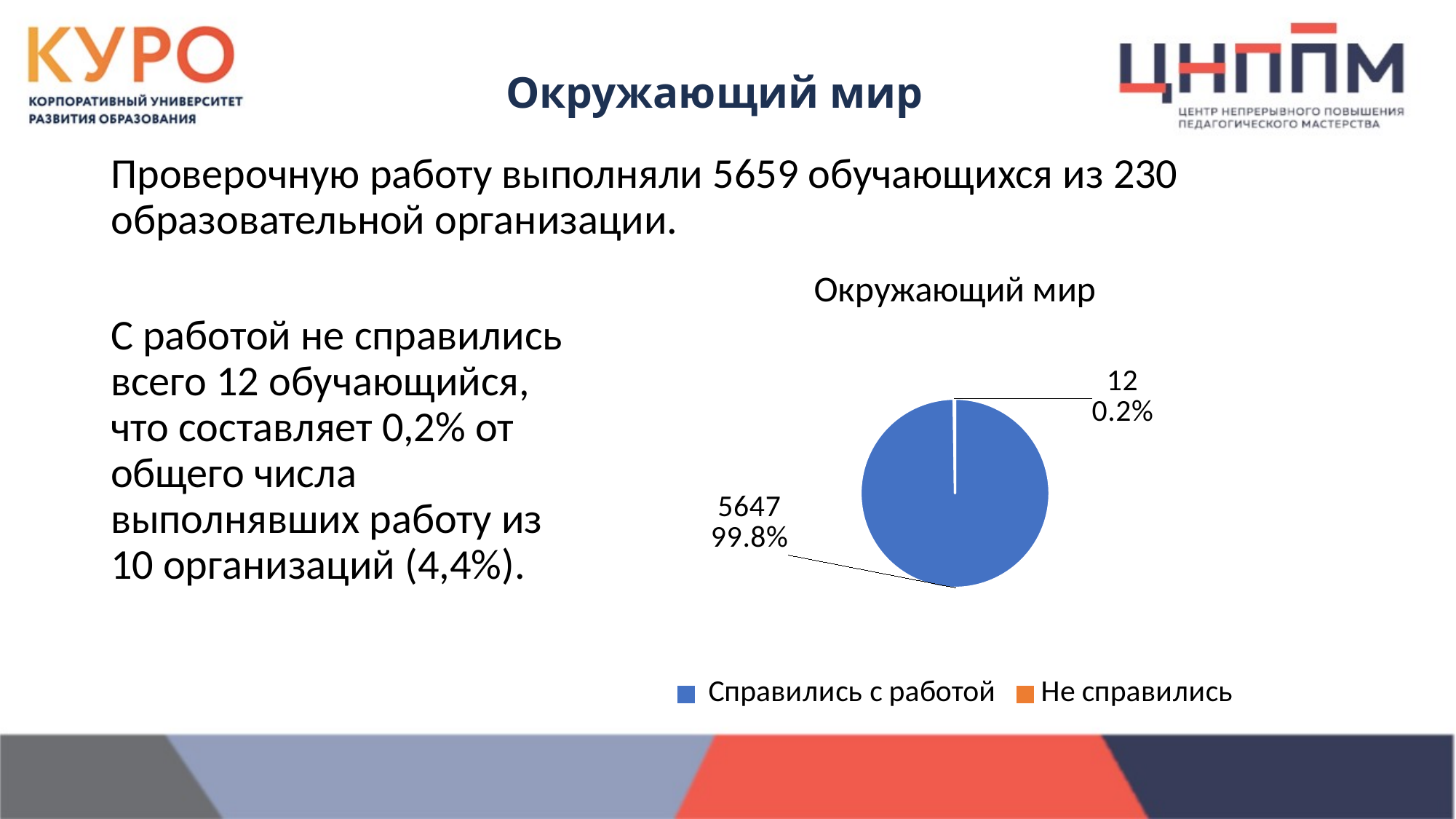
Which category has the smallest slice of the pie? Не справились What is the difference between the values for "Справились с работой" and "Не справились"? 5635 Which category has the largest slice of the pie? Справились с работой What is the value for "Справились с работой"? 5647 What share of the pie does "Не справились" represent? 0.2% What is the total of the two slices in the pie chart? 5659 Which colour represents "Не справились" in the legend? orange What is the value for "Не справились"? 12 What type of chart is shown on the slide? pie chart What share of the pie does "Справились с работой" represent? 99.8% What is the title of the chart? Окружающий мир How many series does the chart legend list? 2